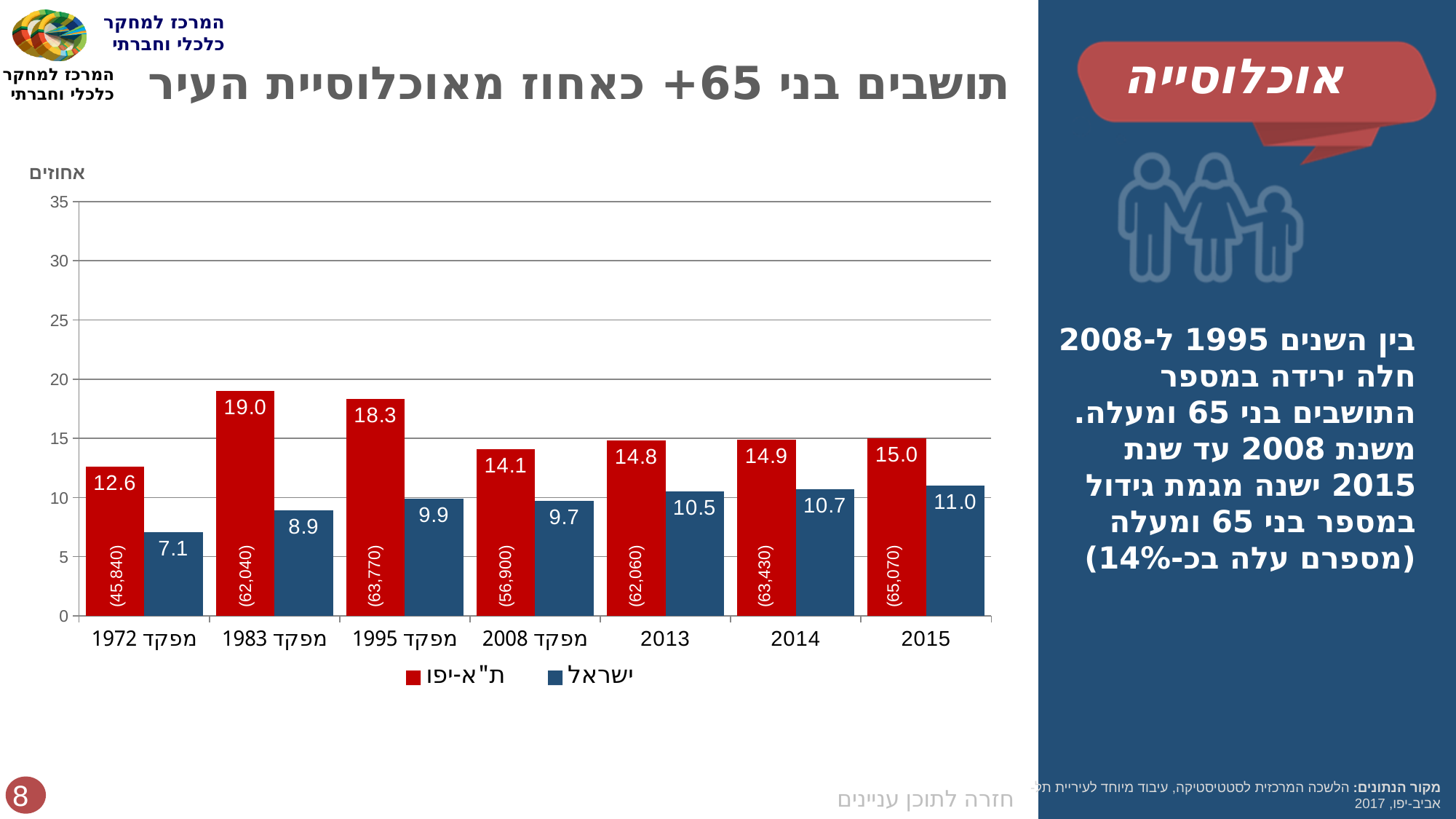
In which category is the ישראל value lowest? מפקד 1972 Is the ת"א-יפו value in מפקד 1972 greater or less than 10? greater What kind of chart is shown on the slide? bar chart What is the difference between the ת"א-יפו and ישראל values in מפקד 2008? 4.4 Which is larger: the ת"א-יפו value in מפקד 1995 or in 2013? מפקד 1995 What is the value for ת"א-יפו in מפקד 1983? 19.0 What is the value for ישראל in מפקד 1972? 7.1 How many series does the legend list? 2 In which category is the ת"א-יפו value highest? מפקד 1983 What number is printed in parentheses inside the ת"א-יפו bar for 2015? (65,070) What is the value for ישראל in 2015? 11.0 How many categories are shown on the x axis? 7